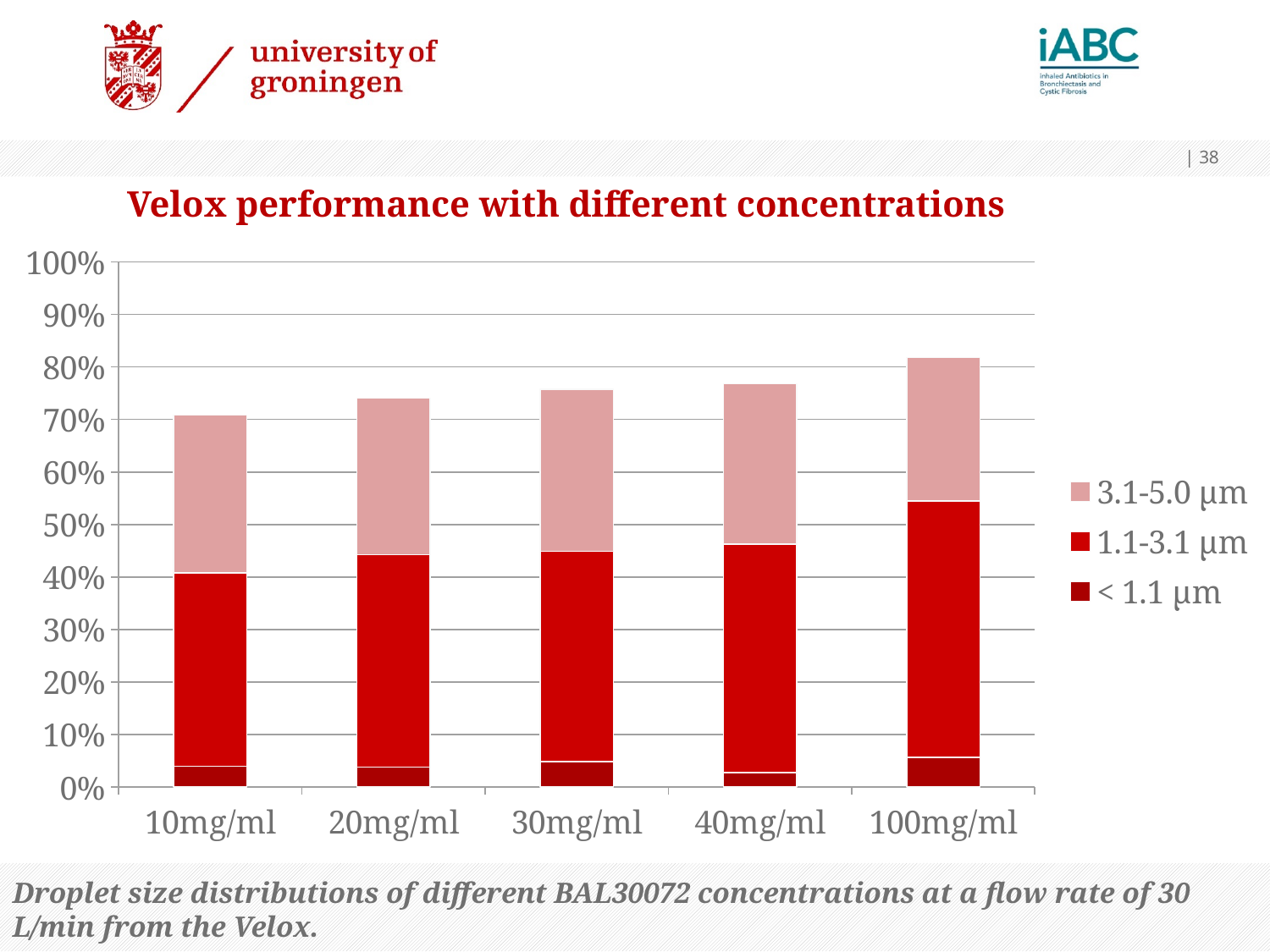
Is the total stacked bar for 40mg/ml greater or less than 70%? greater How many series does the legend list? 3 Is the total stacked bar for 10mg/ml greater or less than 80%? less Which legend entry is shown in the lightest pink colour? 3.1-5.0 µm Which concentration has the lowest total stacked bar? 10mg/ml What is the title of the chart? Velox performance with different concentrations Do the total bar heights rise or fall as concentration increases from 10mg/ml to 100mg/ml? rise Is the total stacked bar for 100mg/ml greater or less than 80%? greater Which concentration has the highest total stacked bar? 100mg/ml Which total stacked bar is taller, 100mg/ml or 10mg/ml? 100mg/ml How many concentration categories are shown on the x axis? 5 What kind of chart is shown on the slide? stacked bar chart